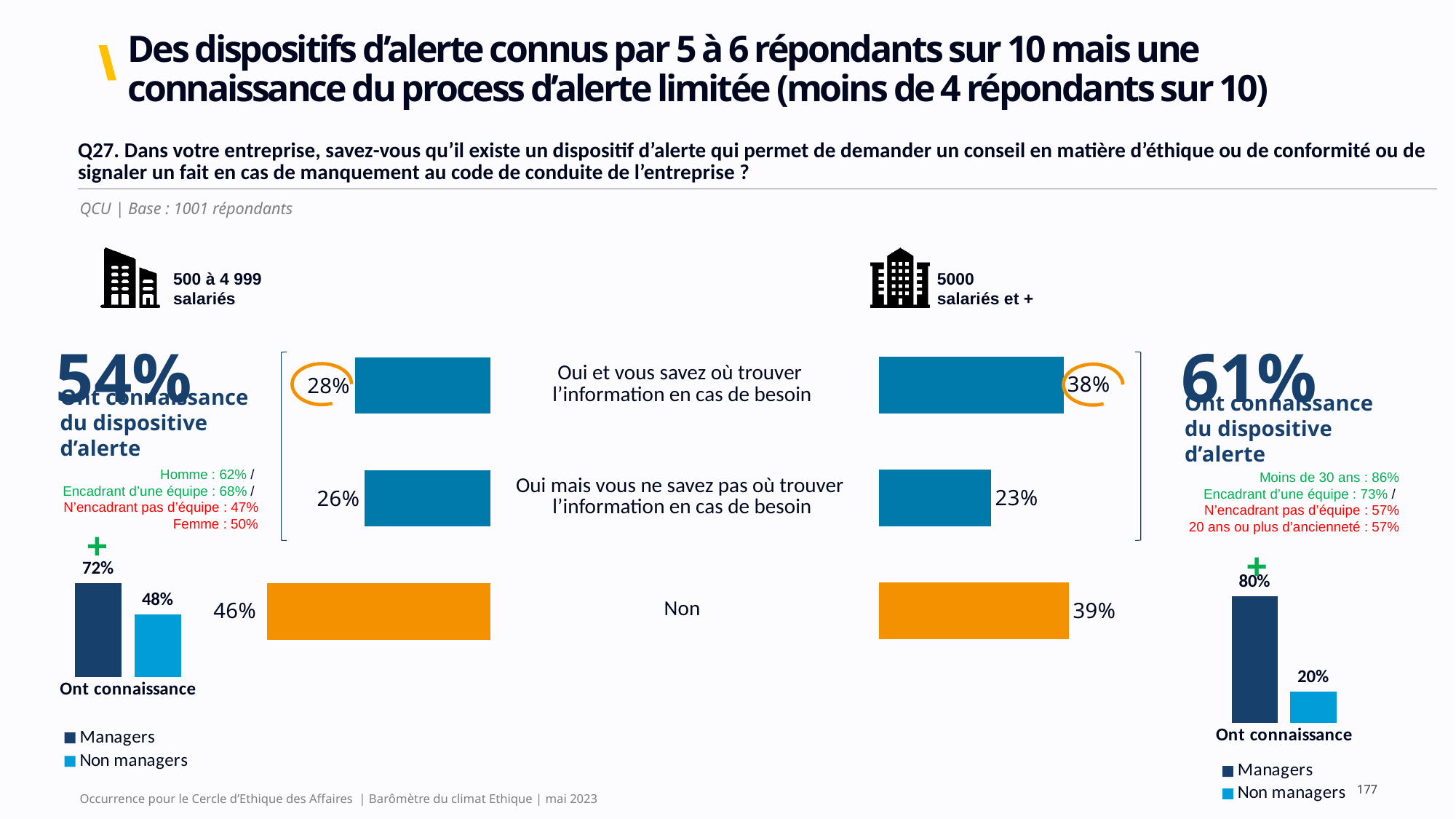
In the small vertical bar chart at the bottom left ("Ont connaissance", 500 à 4 999 salariés), what is the value for Managers? 72% In the horizontal bar chart for companies with 500 à 4 999 salariés, which category has the highest value? Non In the horizontal bar chart for companies with 5000 salariés et +, which category has the lowest value? Oui mais vous ne savez pas où trouver l'information en cas de besoin In the horizontal bar chart for companies with 5000 salariés et +, what is the value for "Oui mais vous ne savez pas où trouver l'information en cas de besoin"? 23% In the small vertical bar chart at the bottom right ("Ont connaissance", 5000 salariés et +), what is the value for Non managers? 20% In the small vertical bar chart at the bottom right ("Ont connaissance", 5000 salariés et +), what is the difference between Managers and Non managers? 60 points In the horizontal bar chart for companies with 500 à 4 999 salariés, what is the value for "Non"? 46% How many series does the legend of the bottom-left vertical bar chart list? 2 In the horizontal bar chart for companies with 5000 salariés et +, what is the value for "Oui et vous savez où trouver l'information en cas de besoin"? 38% What is the difference between the "Non" values in the 500 à 4 999 salariés chart and the 5000 salariés et + chart? 7 points Which is larger: the "Oui et vous savez où trouver l'information" value for 500 à 4 999 salariés or for 5000 salariés et +? 5000 salariés et + What type of chart is used to show the three response categories for 500 à 4 999 salariés? Bar chart